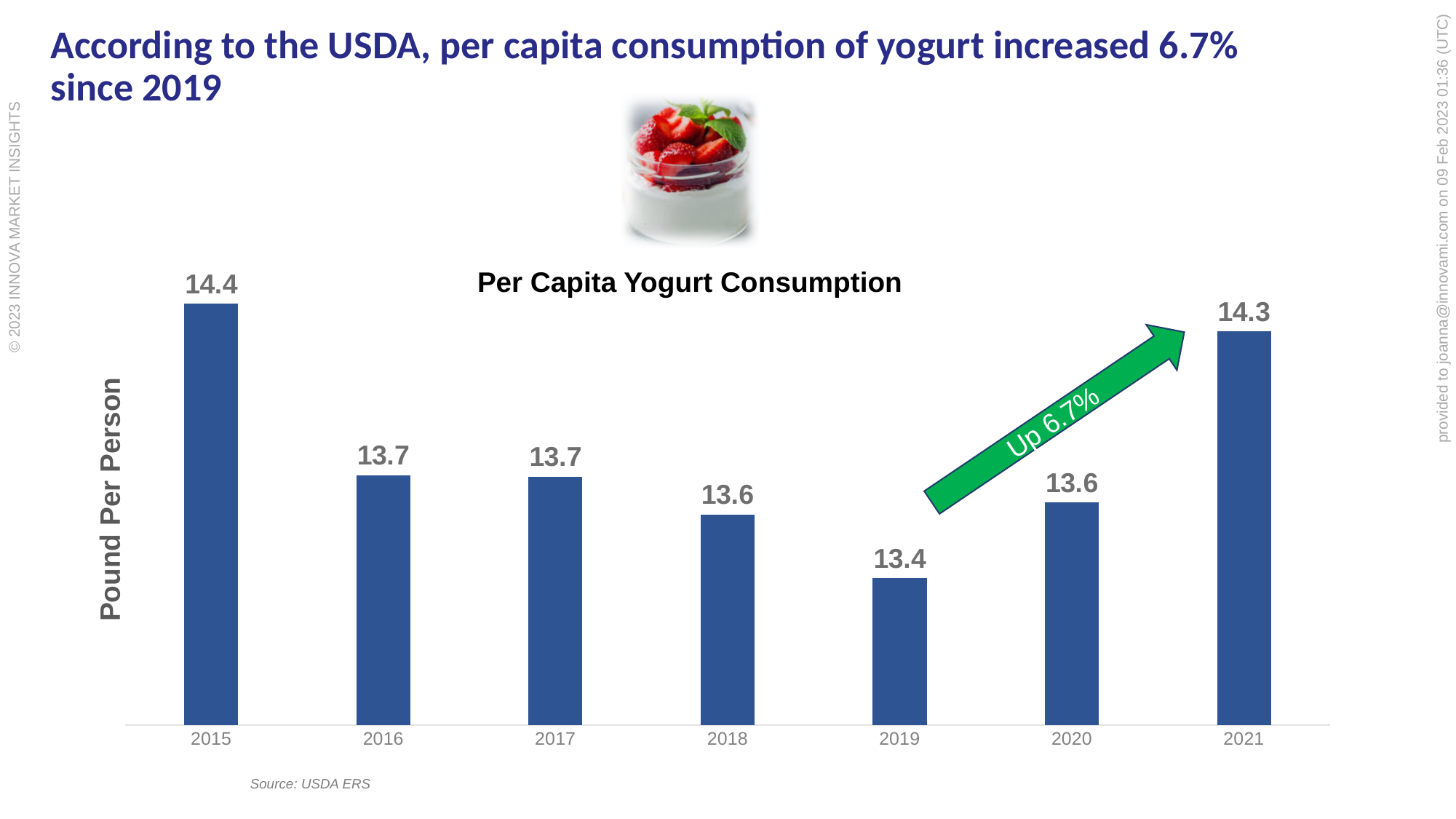
What was per capita yogurt consumption in 2021? 14.3 Which year had higher per capita yogurt consumption, 2020 or 2021? 2021 What was per capita yogurt consumption in 2018? 13.6 What was per capita yogurt consumption in 2019? 13.4 What is the difference in per capita yogurt consumption between 2015 and 2016? 0.7 What is the label on the vertical axis of the chart? Pound Per Person What type of chart is shown on the slide? Bar chart Which year had the lowest per capita yogurt consumption? 2019 How many years are shown in the chart? 7 What is the difference in per capita yogurt consumption between 2021 and 2019? 0.9 Which year had the highest per capita yogurt consumption? 2015 What was per capita yogurt consumption in 2015? 14.4